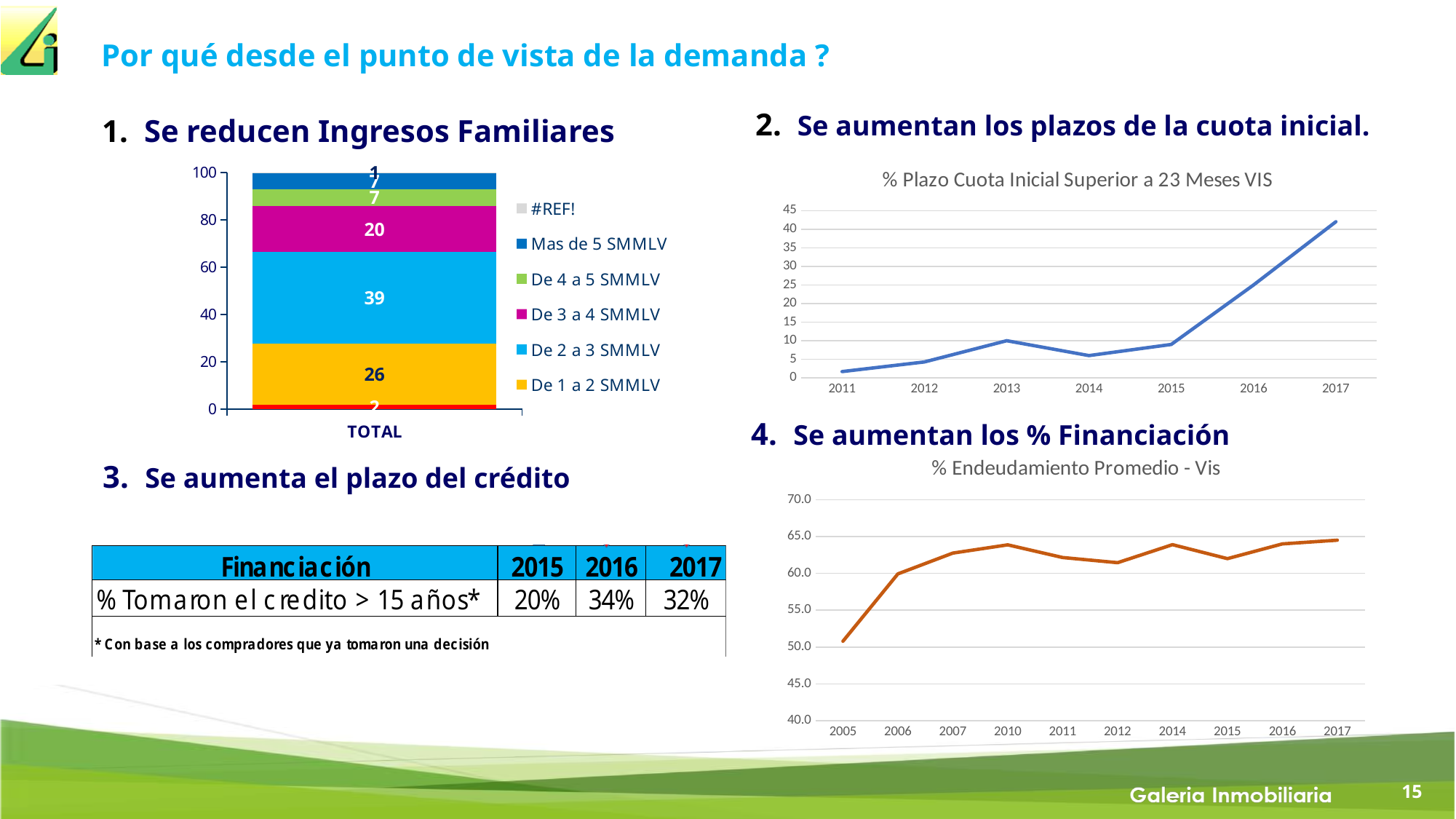
In the stacked bar chart under 'Se reducen Ingresos Familiares', what is the value of the 'De 3 a 4 SMMLV' segment? 20 In the chart '% Plazo Cuota Inicial Superior a 23 Meses VIS', which year has the highest value? 2017 In the stacked bar chart under 'Se reducen Ingresos Familiares', what is the value of the 'De 1 a 2 SMMLV' segment? 26 In the chart '% Endeudamiento Promedio - Vis', is the value for 2005 greater or less than 55.0? less How many years are shown on the x axis of the chart '% Plazo Cuota Inicial Superior a 23 Meses VIS'? 7 In the chart '% Plazo Cuota Inicial Superior a 23 Meses VIS', is the value for 2017 greater or less than 40? greater In the stacked bar chart under 'Se reducen Ingresos Familiares', what is the difference between the 'De 2 a 3 SMMLV' and 'De 3 a 4 SMMLV' segments? 19 In the stacked bar chart under 'Se reducen Ingresos Familiares', which legend category has the largest segment? De 2 a 3 SMMLV What kind of chart is '% Plazo Cuota Inicial Superior a 23 Meses VIS'? line chart In the stacked bar chart under 'Se reducen Ingresos Familiares', what is the value of the 'De 2 a 3 SMMLV' segment? 39 In the chart '% Endeudamiento Promedio - Vis', which year has the lowest value? 2005 How many entries does the legend of the stacked bar chart under 'Se reducen Ingresos Familiares' list? 6